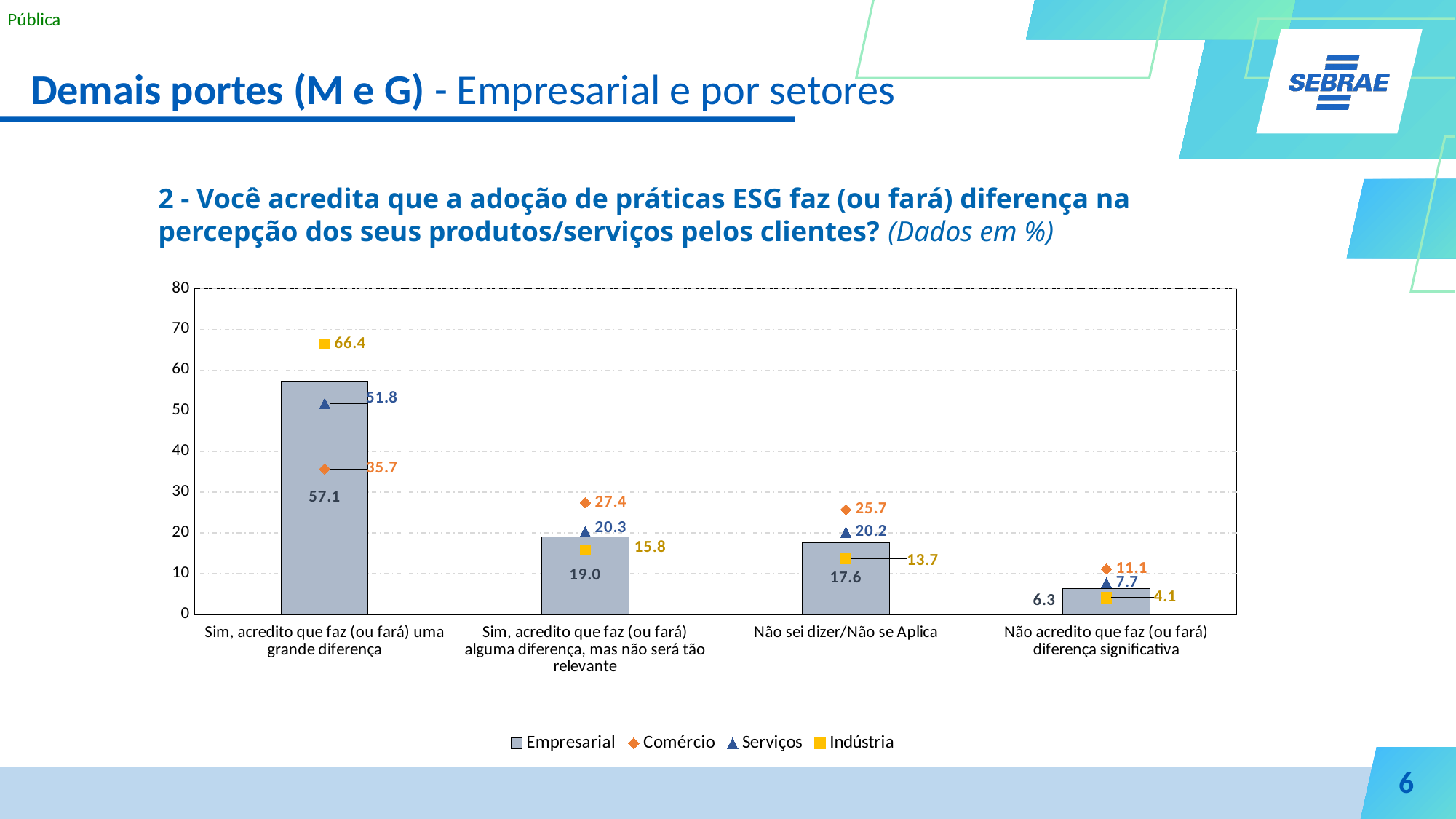
How many categories are shown on the x axis? 4 Which category has the lowest Indústria value? Não acredito que faz (ou fará) diferença significativa Do the Empresarial values rise or fall from left to right across the categories? fall What is the Comércio value for "Não sei dizer/Não se Aplica"? 25.7 For "Sim, acredito que faz (ou fará) alguma diferença, mas não será tão relevante", which is larger: the Comércio value or the Indústria value? Comércio Which category has the highest Empresarial value? Sim, acredito que faz (ou fará) uma grande diferença What is the Serviços value for "Não acredito que faz (ou fará) diferença significativa"? 7.7 What is the difference between the Indústria and Comércio values for "Sim, acredito que faz (ou fará) uma grande diferença"? 30.7 What is the Indústria value for "Sim, acredito que faz (ou fará) uma grande diferença"? 66.4 What is the Empresarial value for "Sim, acredito que faz (ou fará) uma grande diferença"? 57.1 Which series is shown as bars rather than markers? Empresarial How many series does the legend list? 4